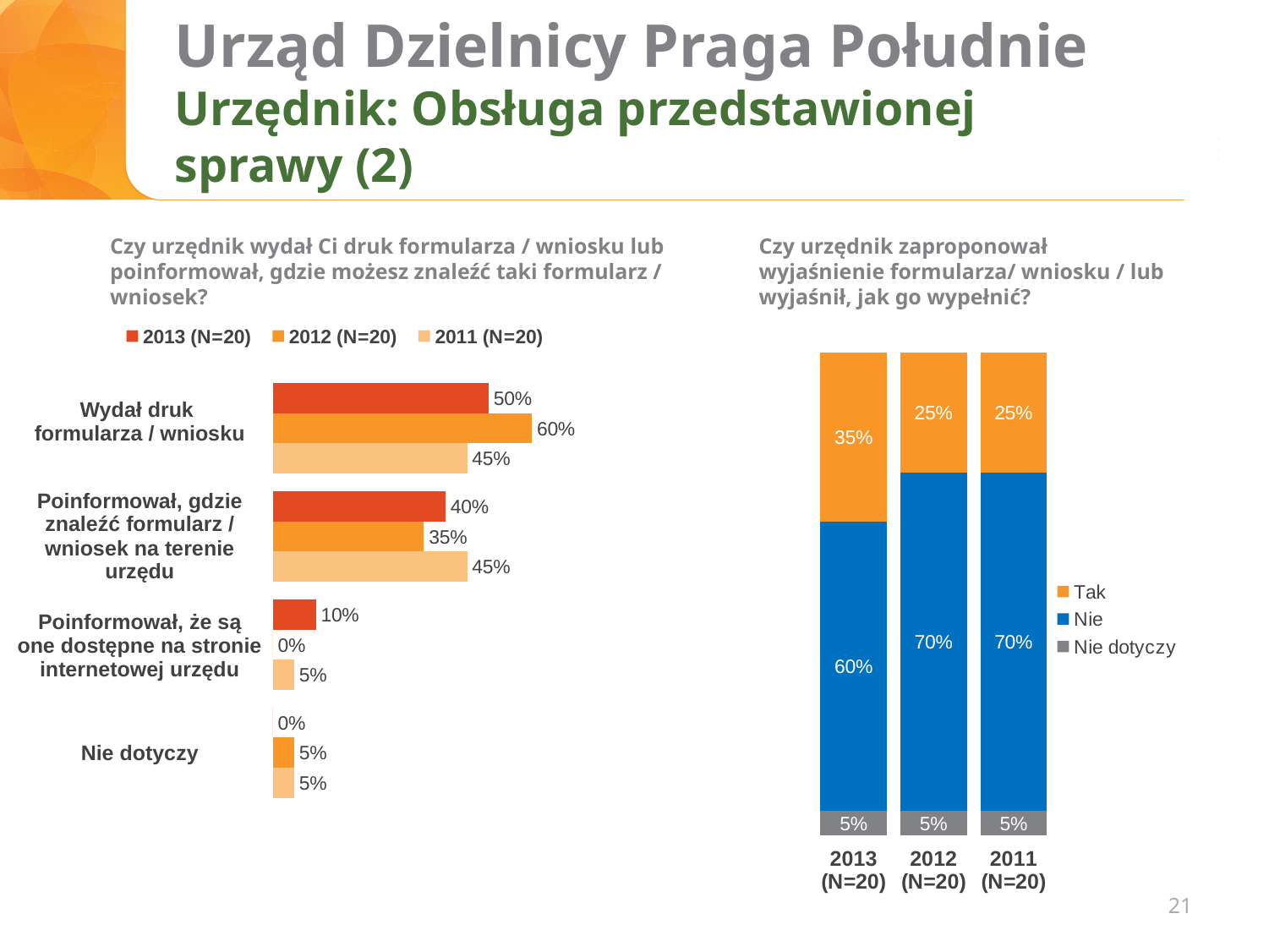
In the left chart, what is the difference between the 2012 (N=20) and 2011 (N=20) values for 'Wydał druk formularza / wniosku'? 15% In the left chart, which category has the highest 2013 (N=20) value? Wydał druk formularza / wniosku In the right chart, what is the 'Nie' value for 2012 (N=20)? 70% In the left chart, what is the 2013 (N=20) value for 'Poinformował, gdzie znaleźć formularz / wniosek na terenie urzędu'? 40% What kind of chart is the left chart? Bar chart In the left chart, what is the 2012 (N=20) value for 'Wydał druk formularza / wniosku'? 60% In the right chart, what is the 'Tak' value for 2013 (N=20)? 35% In the right chart, what is the total of the 2011 (N=20) stacked bar? 100% In the left chart, which is larger for 'Poinformował, gdzie znaleźć formularz / wniosek na terenie urzędu': the 2012 (N=20) value or the 2011 (N=20) value? 2011 (N=20) How many categories are shown in the left chart? 4 In the left chart, what is the 2011 (N=20) value for 'Poinformował, że są one dostępne na stronie internetowej urzędu'? 5% How many series does the legend of the left chart list? 3